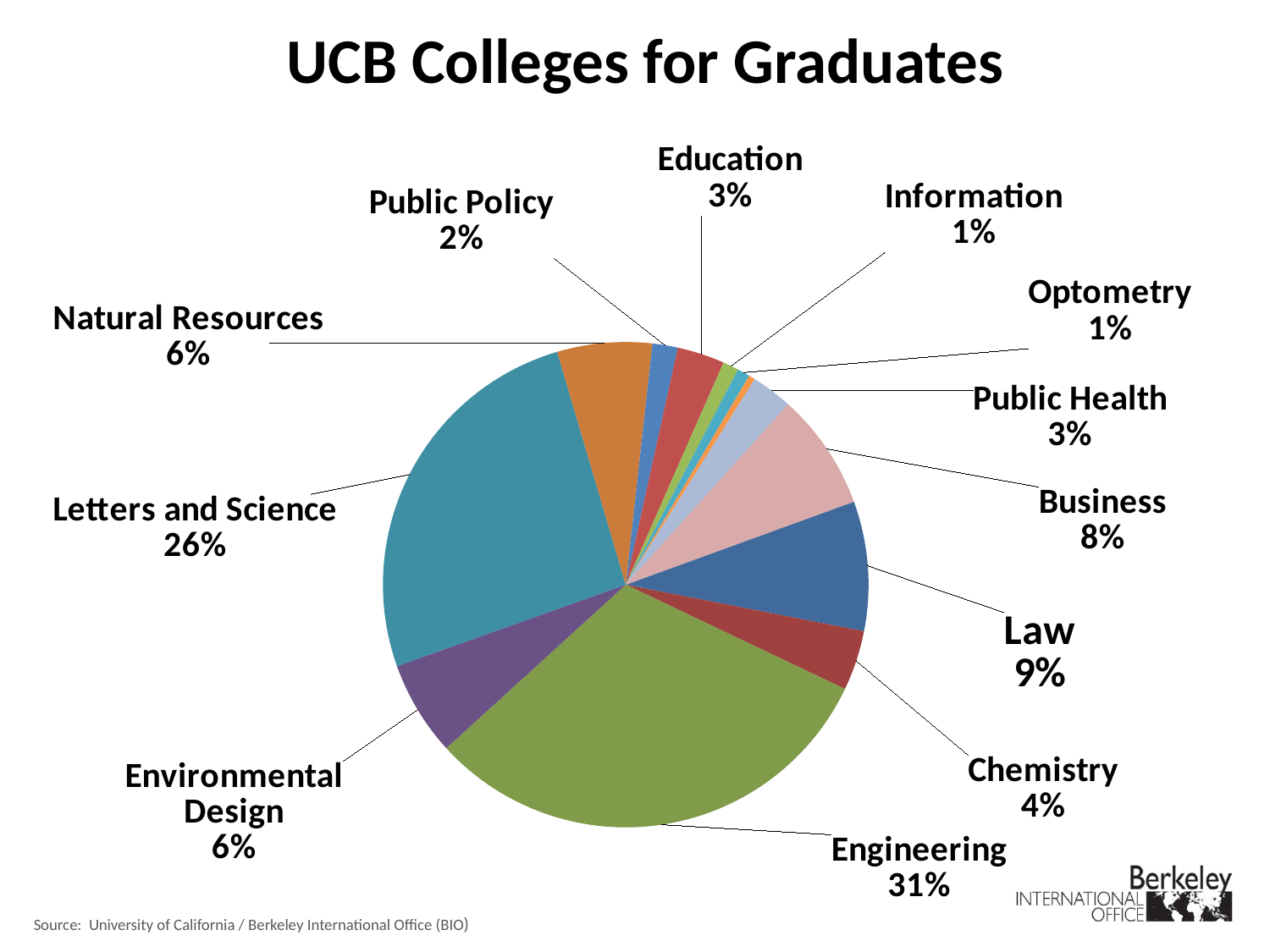
What share of graduates is in Engineering? 31% Which college has the largest share of graduates? Engineering What percentage is shown for Environmental Design? 6% What is the difference in percentage points between Engineering and Letters and Science? 5 Which is larger, the share for Business or the share for Law? Law What share of graduates is in Letters and Science? 26% What percentage is shown for Law? 9% What percentage is shown for Public Policy? 2% What is the title of the chart? UCB Colleges for Graduates What is the difference in percentage points between Law and Chemistry? 5 What type of chart is shown on the slide? pie chart